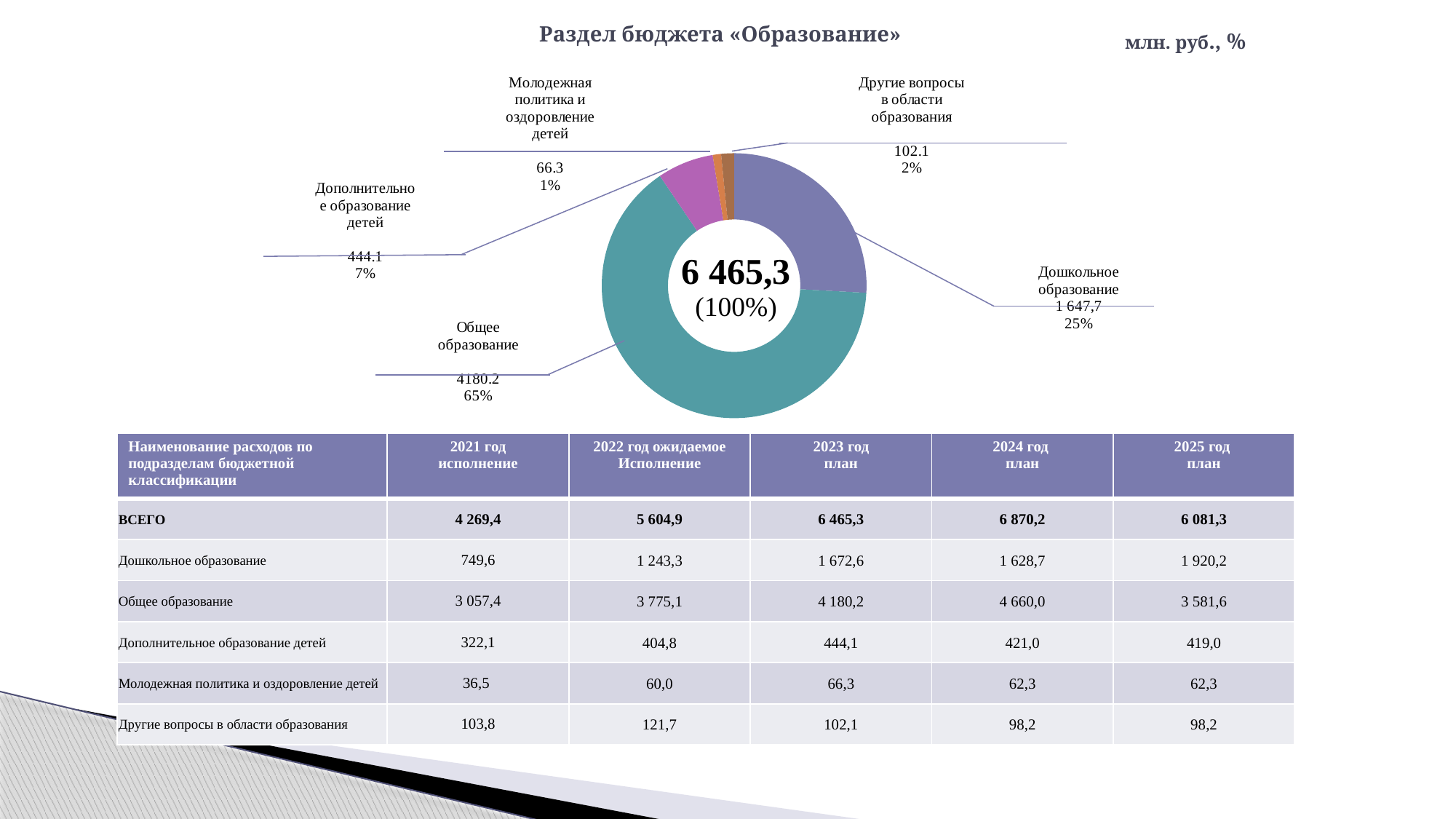
What kind of chart is shown on the slide? Doughnut (pie) chart What is the value shown for Дополнительное образование детей on the chart? 444.1 What share of the chart does Молодежная политика и оздоровление детей represent? 1% Which category has the largest slice of the chart? Общее образование What share of the chart does Дошкольное образование represent? 25% What is the value shown for Общее образование on the chart? 4180.2 Which is larger on the chart: Дополнительное образование детей or Другие вопросы в области образования? Дополнительное образование детей What is the value shown for Другие вопросы в области образования on the chart? 102.1 Which category has the smallest slice of the chart? Молодежная политика и оздоровление детей What total value is shown in the centre of the chart? 6 465,3 How many categories (slices) does the chart show? 5 What is the title of the chart? Раздел бюджета «Образование»